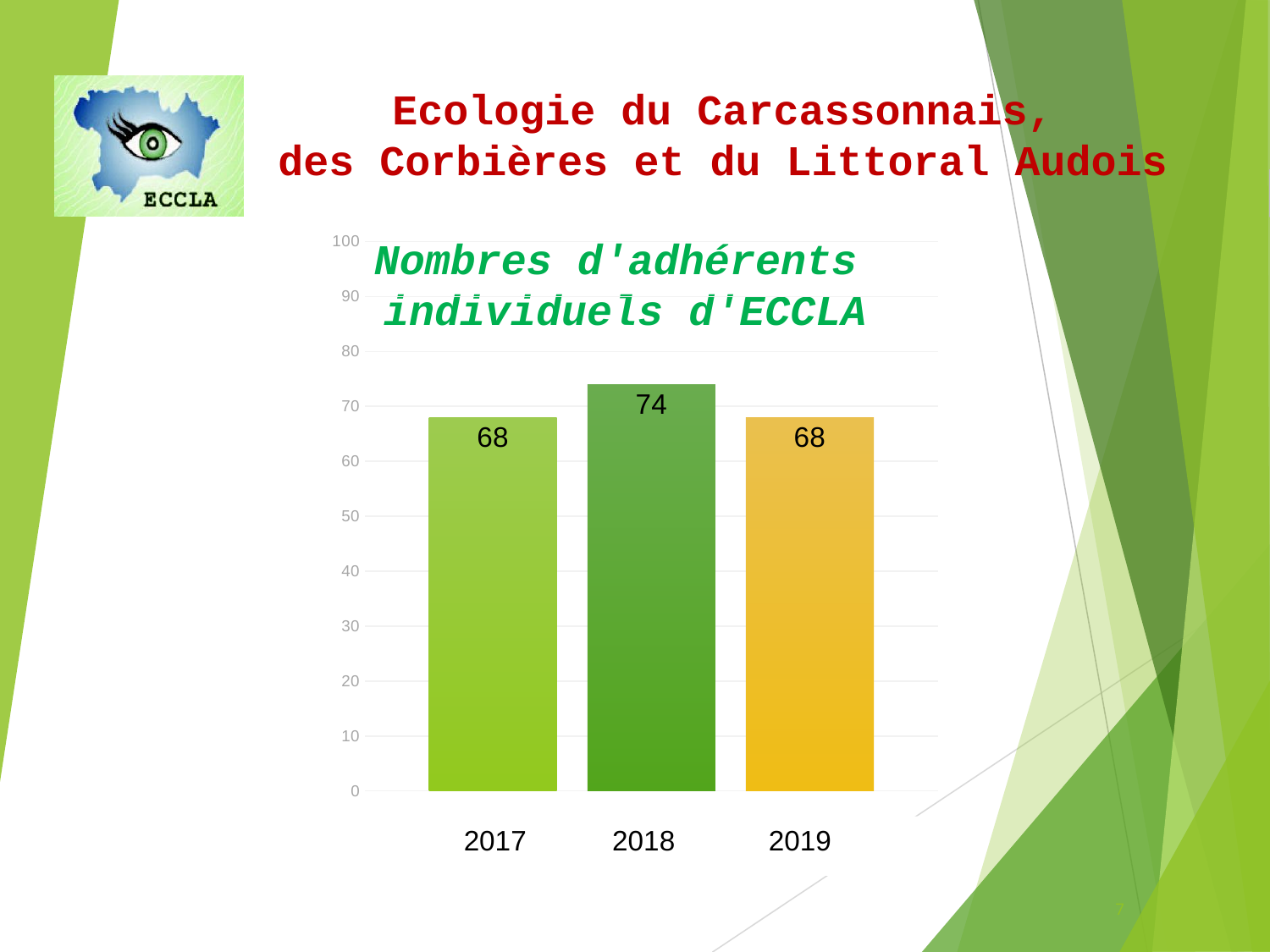
What is the number of individual members in 2017? 68 Which year has the highest number of individual members? 2018 What is the title of the chart? Nombres d'adhérents individuels d'ECCLA Is the value for 2017 greater or less than 70? less What is the number of individual members in 2018? 74 How many years are shown on the x axis? 3 Which is larger, the value for 2018 or the value for 2019? 2018 What is the number of individual members in 2019? 68 What is the difference between the 2018 value and the 2017 value? 6 What kind of chart is shown on the slide? bar chart Does the number of members rise or fall from 2018 to 2019? fall Is the value for 2018 greater or less than 70? greater